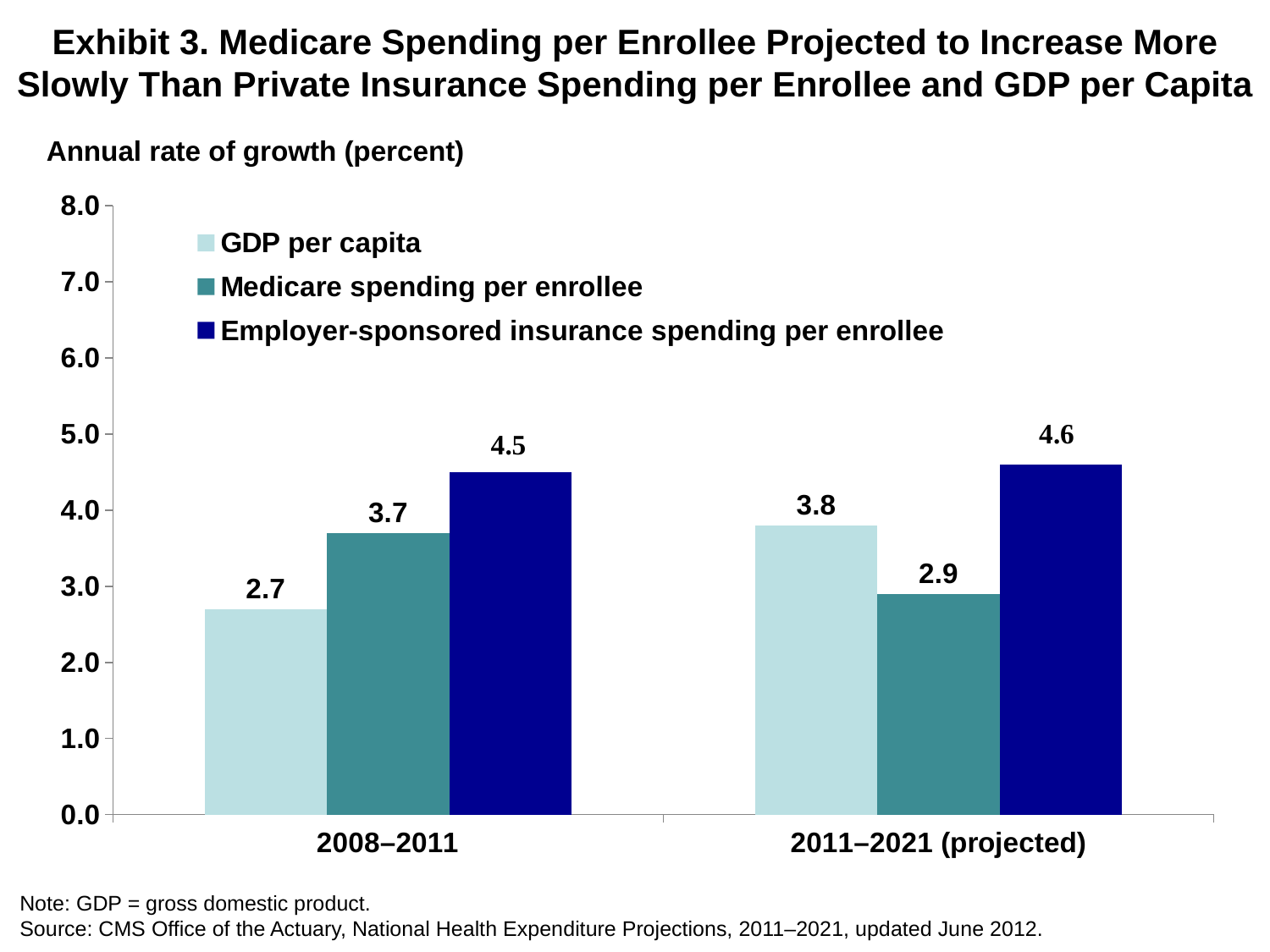
How many series does the legend list? 3 What is the annual rate of growth for GDP per capita in 2008–2011? 2.7 Which series has the lowest annual rate of growth in 2008–2011? GDP per capita What is the label of the y axis? Annual rate of growth (percent) Does the Medicare spending per enrollee growth rate rise or fall from 2008–2011 to 2011–2021 (projected)? Fall What is the annual rate of growth for Employer-sponsored insurance spending per enrollee in 2008–2011? 4.5 What kind of chart is shown on the slide? Bar chart Which is larger in 2011–2021 (projected): GDP per capita growth or Medicare spending per enrollee growth? GDP per capita What is the annual rate of growth for Medicare spending per enrollee in 2011–2021 (projected)? 2.9 What is the difference between the Employer-sponsored insurance spending per enrollee growth rate and the Medicare spending per enrollee growth rate in 2011–2021 (projected)? 1.7 How many time periods are shown on the x axis? 2 Which series has the highest annual rate of growth in 2011–2021 (projected)? Employer-sponsored insurance spending per enrollee